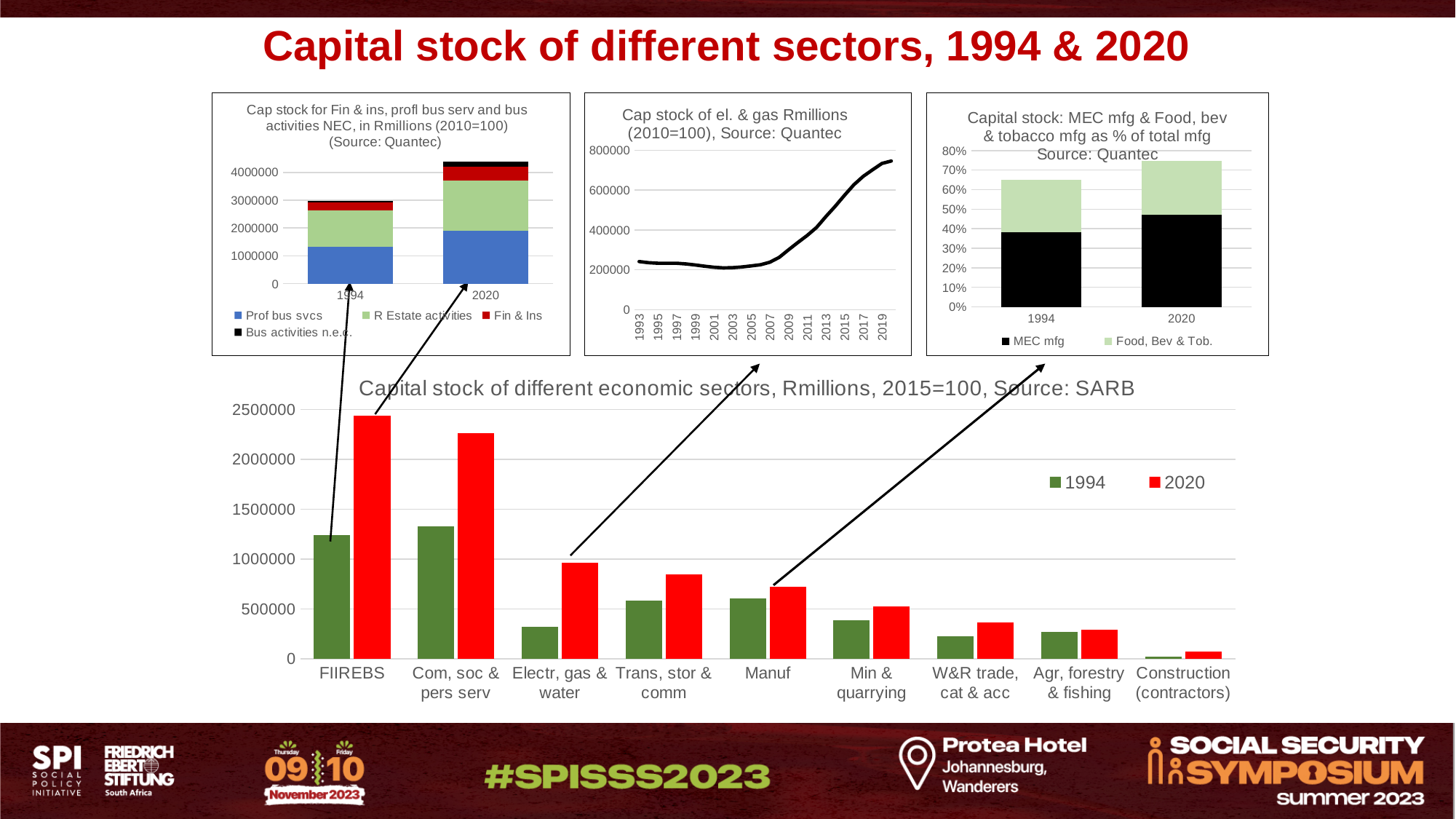
In the bottom chart 'Capital stock of different economic sectors', which sector has the highest value for 2020? FIIREBS How many series does the legend of the bottom chart 'Capital stock of different economic sectors' list? 2 In the bottom chart 'Capital stock of different economic sectors', is the 2020 value for FIIREBS greater or less than 2000000? greater In the top-middle chart 'Cap stock of el. & gas Rmillions', do the values overall rise or fall from 1993 to 2019? rise In the bottom chart 'Capital stock of different economic sectors', which sector has the lowest value for 2020? Construction (contractors) How many series does the legend of the top-left chart 'Cap stock for Fin & ins, profl bus serv and bus activities NEC' list? 4 What kind of chart is the top-middle chart 'Cap stock of el. & gas Rmillions'? line chart In the bottom chart 'Capital stock of different economic sectors', is the 1994 value for Electr, gas & water greater or less than 500000? less How many sectors are shown on the x axis of the bottom chart 'Capital stock of different economic sectors'? 9 In the top-middle chart 'Cap stock of el. & gas Rmillions', is the value for 2019 greater or less than 600000? greater In the bottom chart 'Capital stock of different economic sectors', which is larger for 2020: Trans, stor & comm or Manuf? Trans, stor & comm